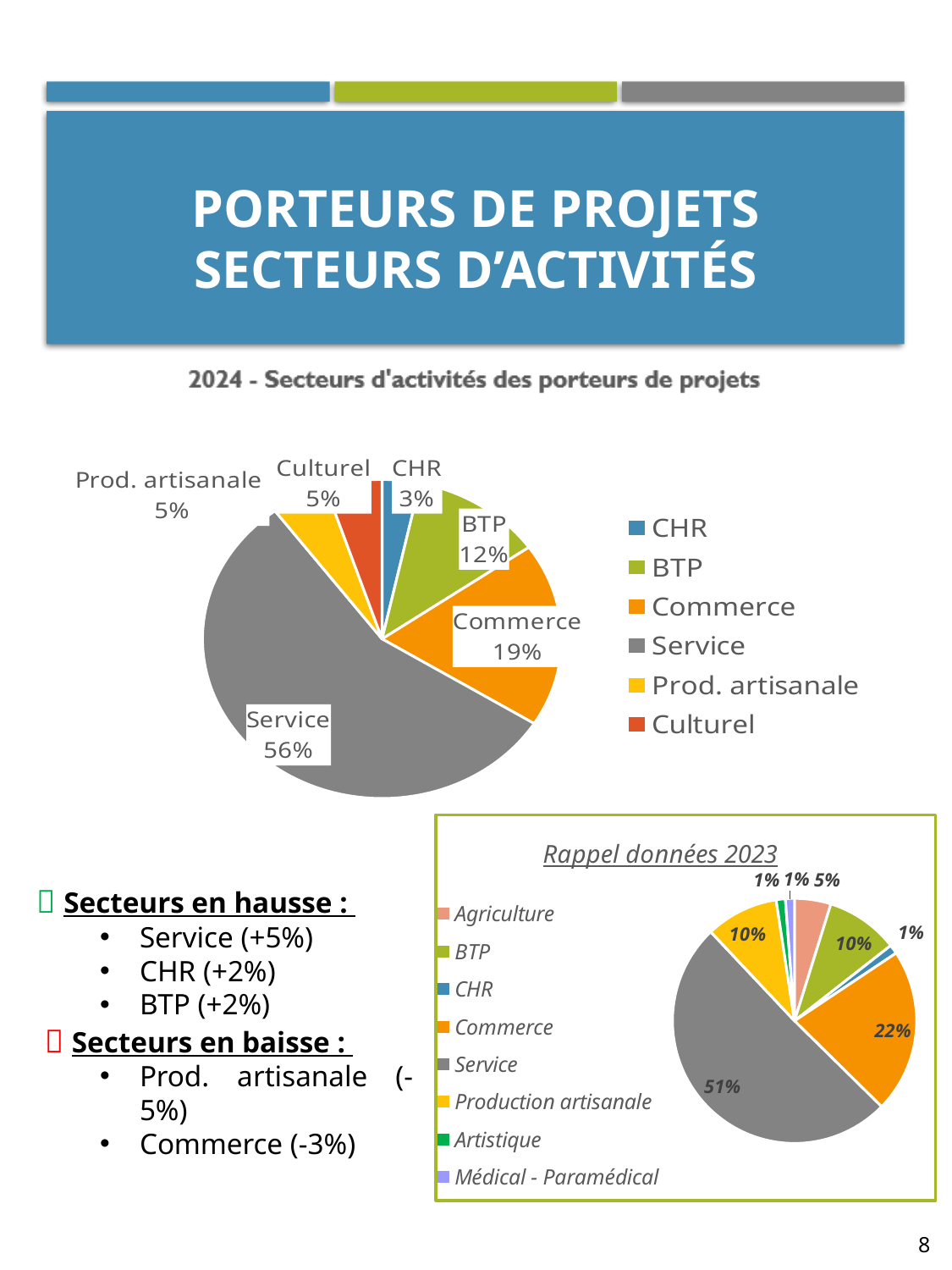
In the 2024 chart, what is the difference between the Commerce share and the BTP share? 7% In the 2024 chart, which sector has the smallest share? CHR In the 2024 chart, what percentage is shown for BTP? 12% What type of chart is the 2024 chart? Pie chart In the 2024 chart, which is larger, the share for Commerce or the share for BTP? Commerce How many sectors does the legend of the 2024 chart list? 6 In the 2024 chart, what share of project holders is in the Service sector? 56% In the 2024 chart, which sector has the largest share? Service In the 2024 chart, what percentage is shown for Commerce? 19% How many sectors does the legend of the Rappel données 2023 chart list? 8 In the Rappel données 2023 chart, what percentage is shown for Commerce? 22% In the Rappel données 2023 chart, what percentage is shown for Service? 51%